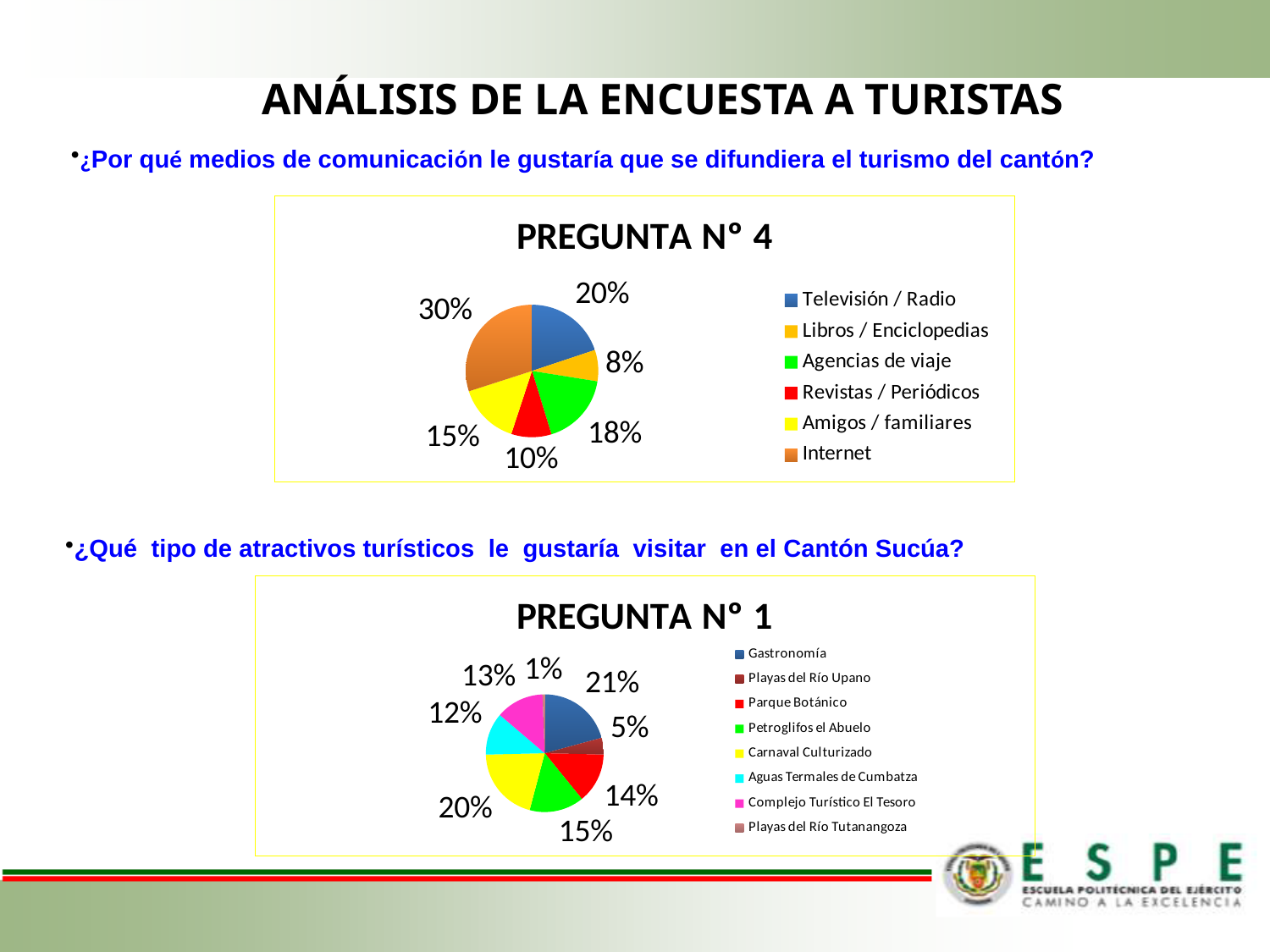
In the PREGUNTA N° 4 chart, how many categories does the legend list? 6 In the PREGUNTA N° 4 chart, what percentage corresponds to Libros / Enciclopedias? 8% In the PREGUNTA N° 4 chart, what percentage corresponds to Internet? 30% In the PREGUNTA N° 4 chart, which category has the smallest share? Libros / Enciclopedias What type of chart is the PREGUNTA N° 1 chart? Pie chart In the PREGUNTA N° 1 chart, what percentage corresponds to Playas del Río Tutanangoza? 1% In the PREGUNTA N° 1 chart, what percentage corresponds to Gastronomía? 21% In the PREGUNTA N° 1 chart, which is larger: Carnaval Culturizado or Parque Botánico? Carnaval Culturizado In the PREGUNTA N° 4 chart, which category has the largest share? Internet In the PREGUNTA N° 4 chart, what is the difference between the shares for Televisión / Radio and Revistas / Periódicos? 10% In the PREGUNTA N° 1 chart, how many categories does the legend list? 8 In the PREGUNTA N° 1 chart, what colour is the slice for Aguas Termales de Cumbatza? Cyan (light blue)